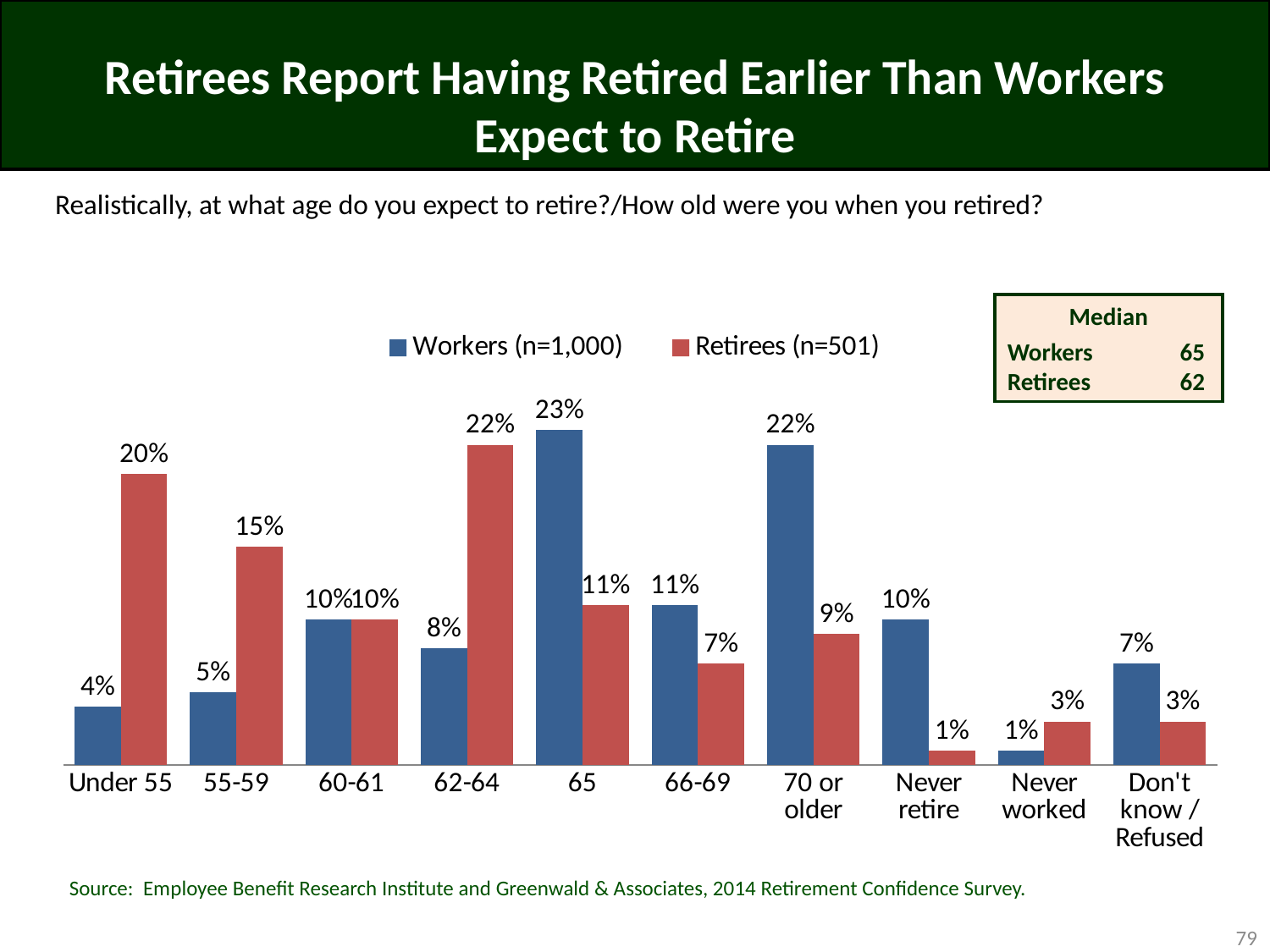
What percentage of Workers expect to retire at age 65? 23% Which age category has the highest value for Retirees? 62-64 According to the Median box, what is the median retirement age for Retirees? 62 In the Under 55 category, how many percentage points higher is the Retirees value than the Workers value? 16 percentage points What kind of chart is shown on the slide? Bar chart How many series does the legend list? 2 What is the Retirees value for the 'Never retire' category? 1% Which category has the lowest value for Workers? Never worked What percentage of Retirees reported retiring at Under 55? 20% In the 62-64 category, which series has the larger value, Workers or Retirees? Retirees How many categories are shown on the x axis? 10 Which age category has the highest value for Workers? 65